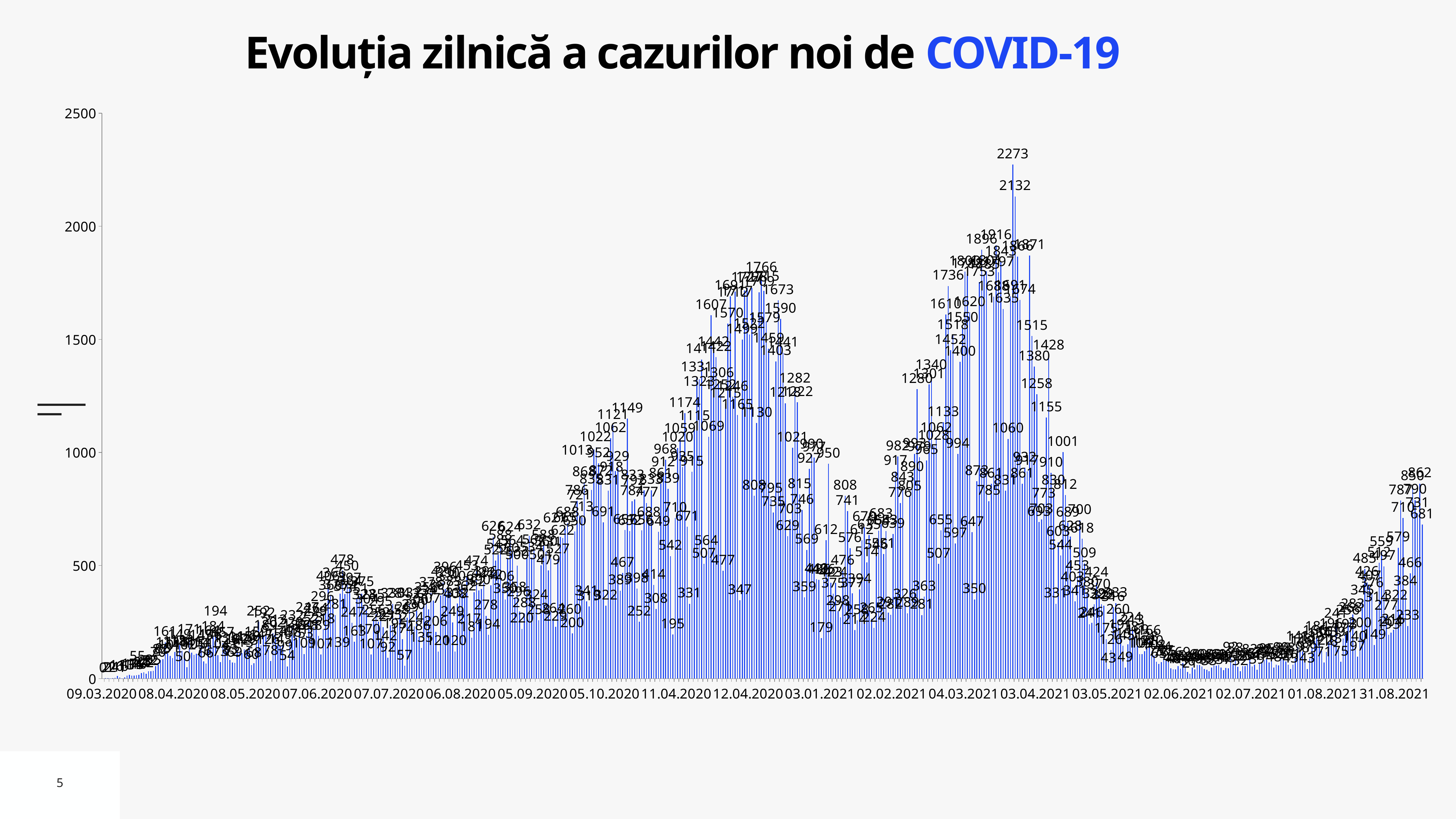
Is the highest bar on the chart greater or less than 2000? greater Is the highest bar on the chart greater or less than 2500? less What is the highest daily value labelled on the chart? 2273 What is the last date label on the horizontal axis? 31.08.2021 Do the daily values rise or fall between the 03.05.2021 and 02.06.2021 axis labels? fall What is the first date label on the horizontal axis? 09.03.2020 What is the title of the chart? Evoluția zilnică a cazurilor noi de COVID-19 What is the difference between the two highest labelled values, 2273 and 2132? 141 What is the second-highest daily value labelled on the chart? 2132 What kind of chart is shown on the slide? bar chart What is the highest tick value shown on the vertical axis? 2500 Which is larger, the bar labelled 2273 or the bar labelled 2132? 2273